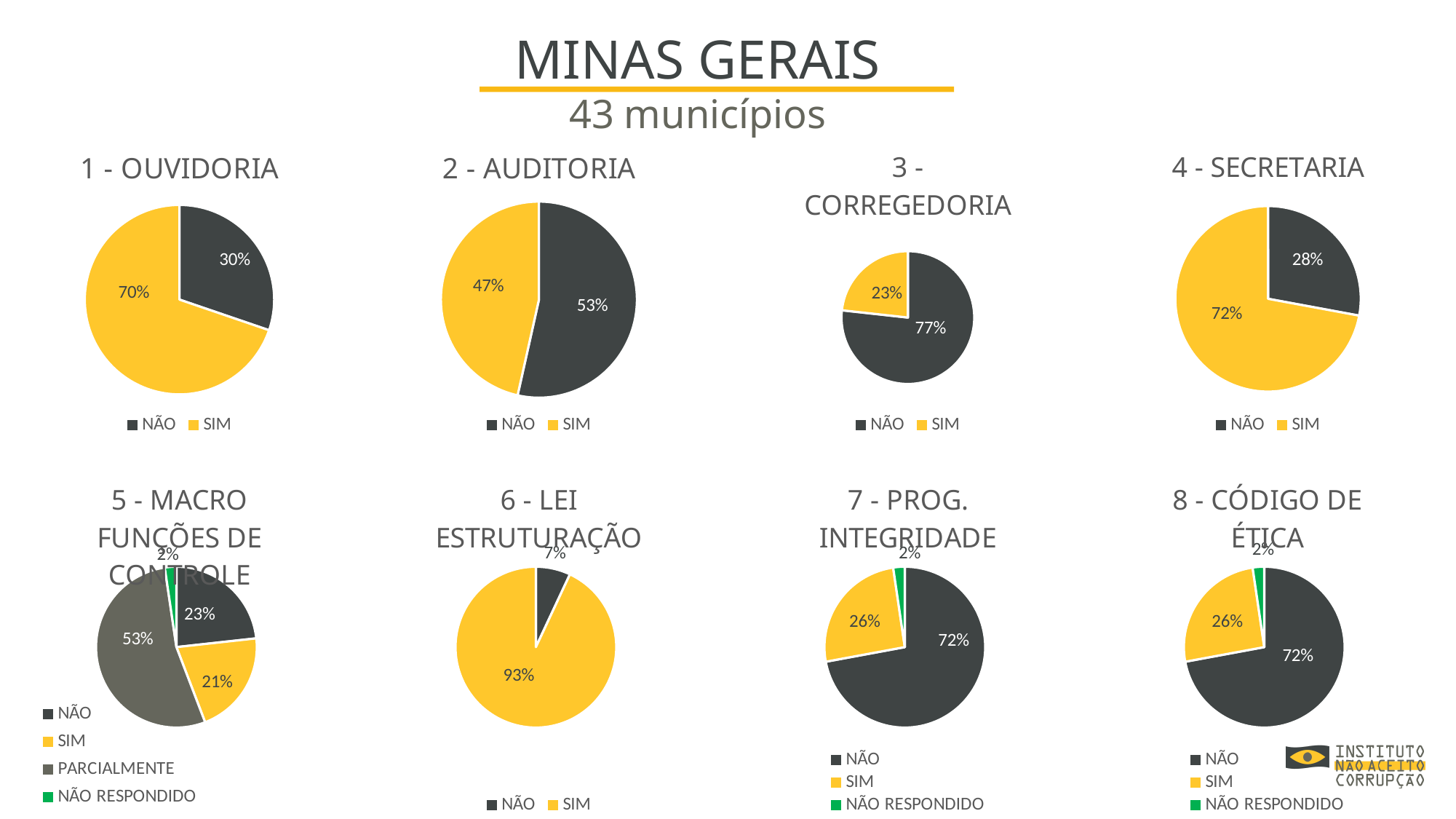
In the "5 - MACRO FUNÇÕES DE CONTROLE" pie chart, which category has the largest slice? PARCIALMENTE In the "1 - OUVIDORIA" pie chart, what share is labelled SIM? 70% How many pie charts are shown on the slide? 8 How many categories does the legend of the "5 - MACRO FUNÇÕES DE CONTROLE" chart list? 4 In the "8 - CÓDIGO DE ÉTICA" pie chart, what share is labelled SIM? 26% In the "5 - MACRO FUNÇÕES DE CONTROLE" pie chart, what share is labelled NÃO RESPONDIDO? 2% In the "7 - PROG. INTEGRIDADE" pie chart, which category has the smallest slice? NÃO RESPONDIDO In the "4 - SECRETARIA" pie chart, what is the difference between the SIM and NÃO shares? 44% In the "3 - CORREGEDORIA" pie chart, which slice is larger, NÃO or SIM? NÃO What type of chart is used for "2 - AUDITORIA"? Pie chart